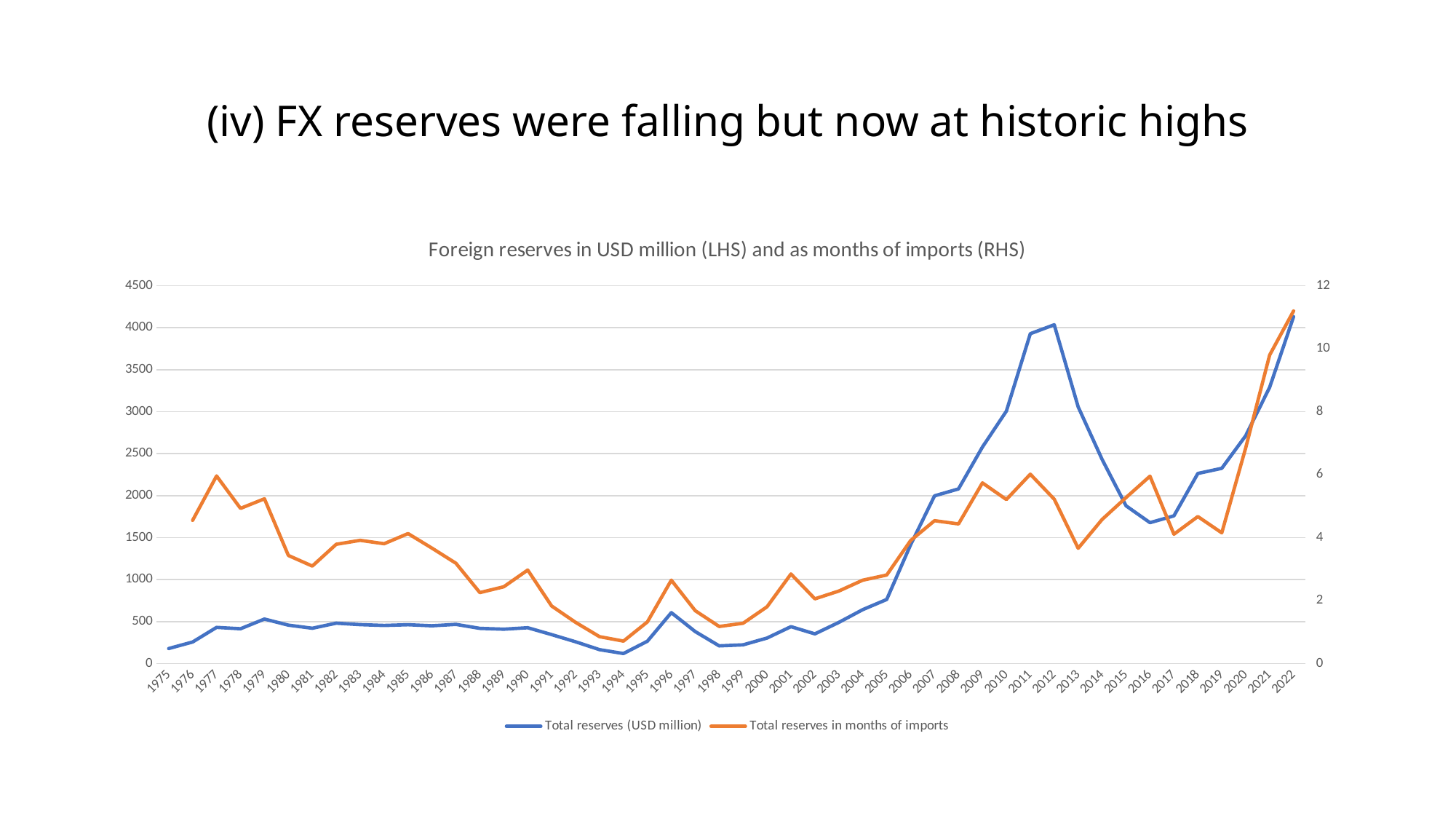
What kind of chart is shown on the slide? line chart How many series does the legend list? 2 Is the value of Total reserves (USD million) in 2012 greater or less than 3500? greater Which year has the larger value of Total reserves (USD million), 2011 or 2016? 2011 Is the value of Total reserves (USD million) in 1994 greater or less than 500? less In which year is Total reserves in months of imports highest? 2022 Is the value of Total reserves in months of imports in 2022 greater or less than 10? greater What is the title of the chart? Foreign reserves in USD million (LHS) and as months of imports (RHS) Which year has the larger value of Total reserves in months of imports, 1977 or 1998? 1977 How many years are plotted along the x axis? 48 Do the values of Total reserves (USD million) rise or fall from 2019 to 2022? rise